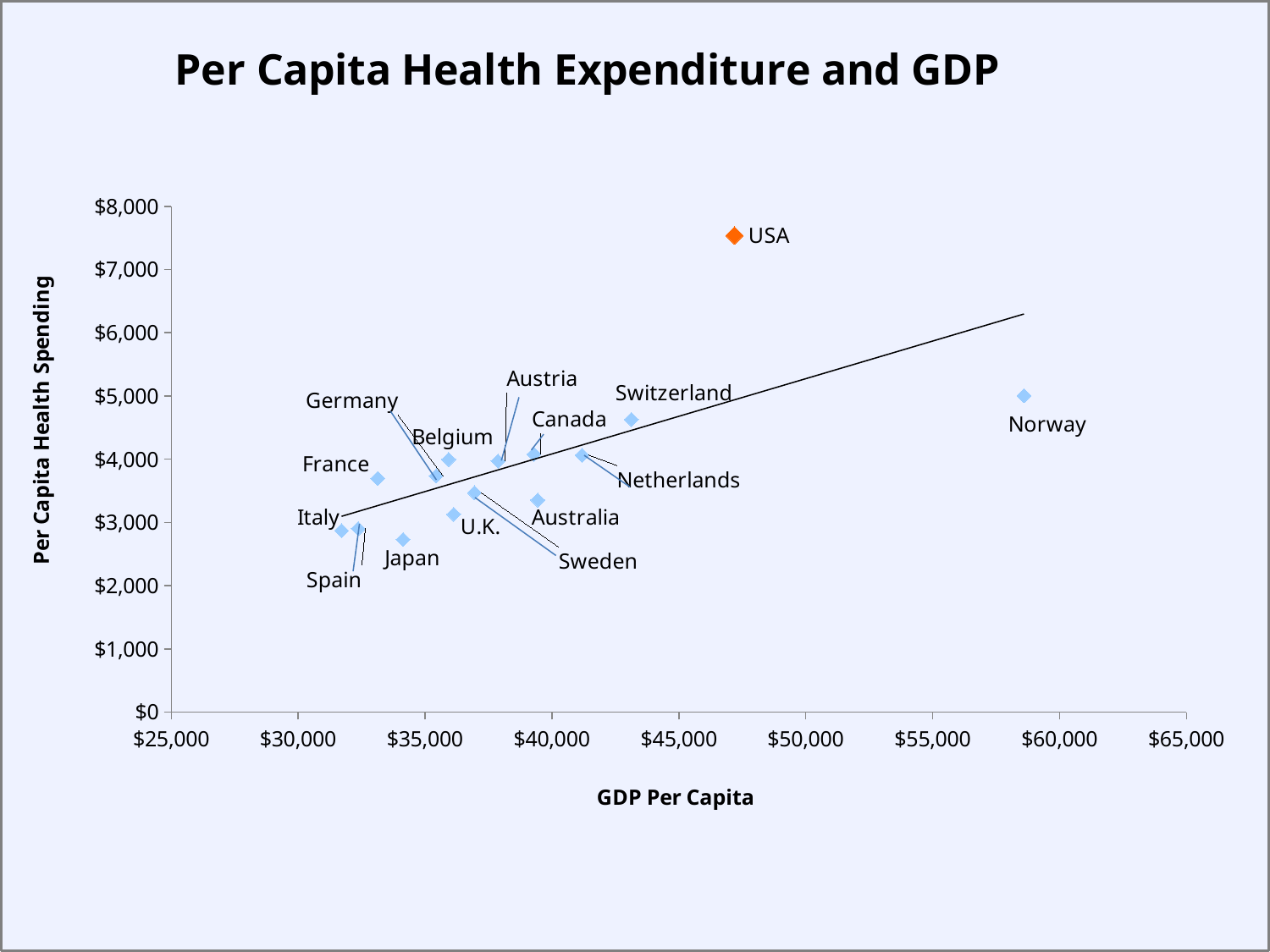
Is the per capita health spending for Japan greater or less than $3,000? less Does the trend line show per capita health spending rising or falling as GDP per capita increases? Rising Is the GDP per capita for France greater or less than $35,000? less What kind of chart is shown on the slide? Scatter chart How many countries are plotted on the chart? 15 Which country has the highest GDP per capita? Norway Is the per capita health spending for the USA greater or less than $7,000? greater Which has higher per capita health spending, Switzerland or Canada? Switzerland Which country has the lowest GDP per capita? Italy Which country has the highest per capita health spending? USA What colour is the marker for the USA? Orange